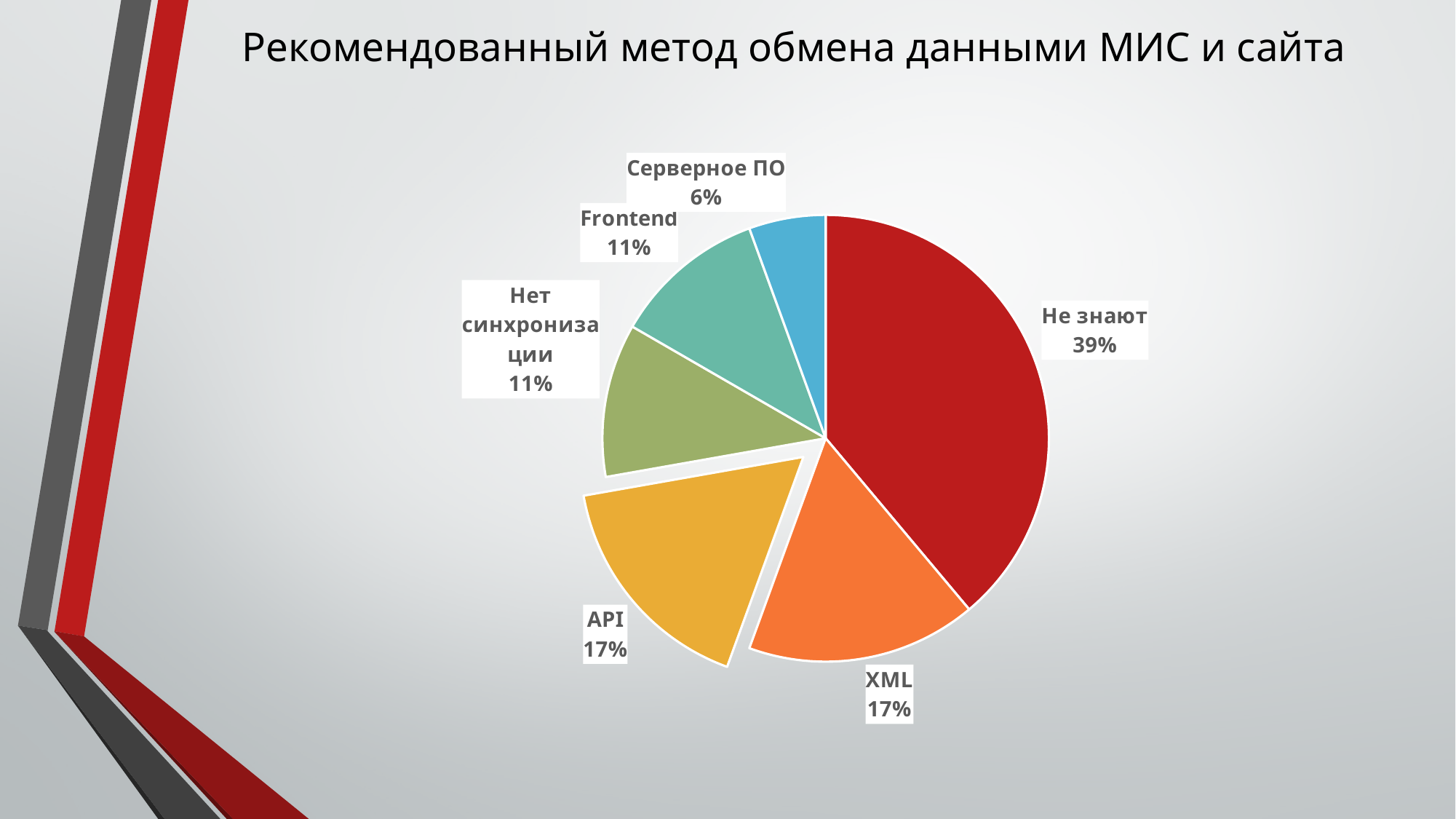
What is the value shown for "API"? 17% What share of the pie does "Не знают" take? 39% What is the title of the chart? Рекомендованный метод обмена данными МИС и сайта Which category has the smallest slice of the pie? Серверное ПО Which slice is pulled out (exploded) from the pie? API What is the difference between the shares of "Не знают" and "XML"? 22% What is the value shown for "Frontend"? 11% How many slices does the pie chart have? 6 What kind of chart is shown on the slide? pie chart Which category has the largest slice of the pie? Не знают What is the value shown for "Серверное ПО"? 6% Which is larger, the share for "API" or the share for "Нет синхронизации"? API